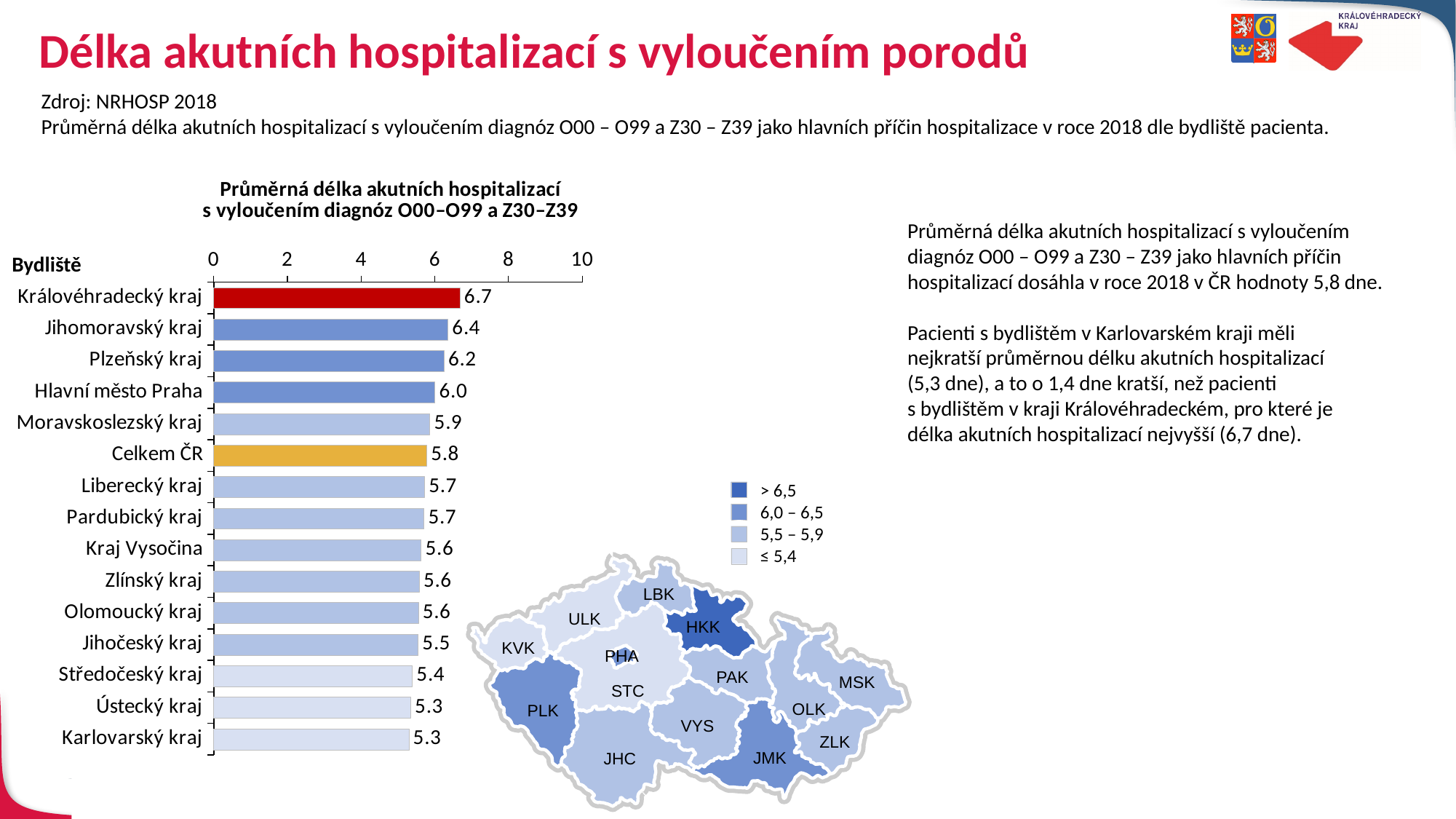
Is the value for Královéhradecký kraj greater or less than 6? greater Which category has the highest value? Královéhradecký kraj What is the lowest value shown in the chart? 5.3 Which is larger, the value for Jihomoravský kraj or the value for Plzeňský kraj? Jihomoravský kraj What is the value for Královéhradecký kraj? 6.7 What is the value for Středočeský kraj? 5.4 What kind of chart is shown on the slide? bar chart What is the difference between the values for Královéhradecký kraj and Karlovarský kraj? 1.4 What is the value for Celkem ČR? 5.8 How many bars are shown in the chart? 15 What colour is the bar for Královéhradecký kraj? red What is the value for Hlavní město Praha? 6.0